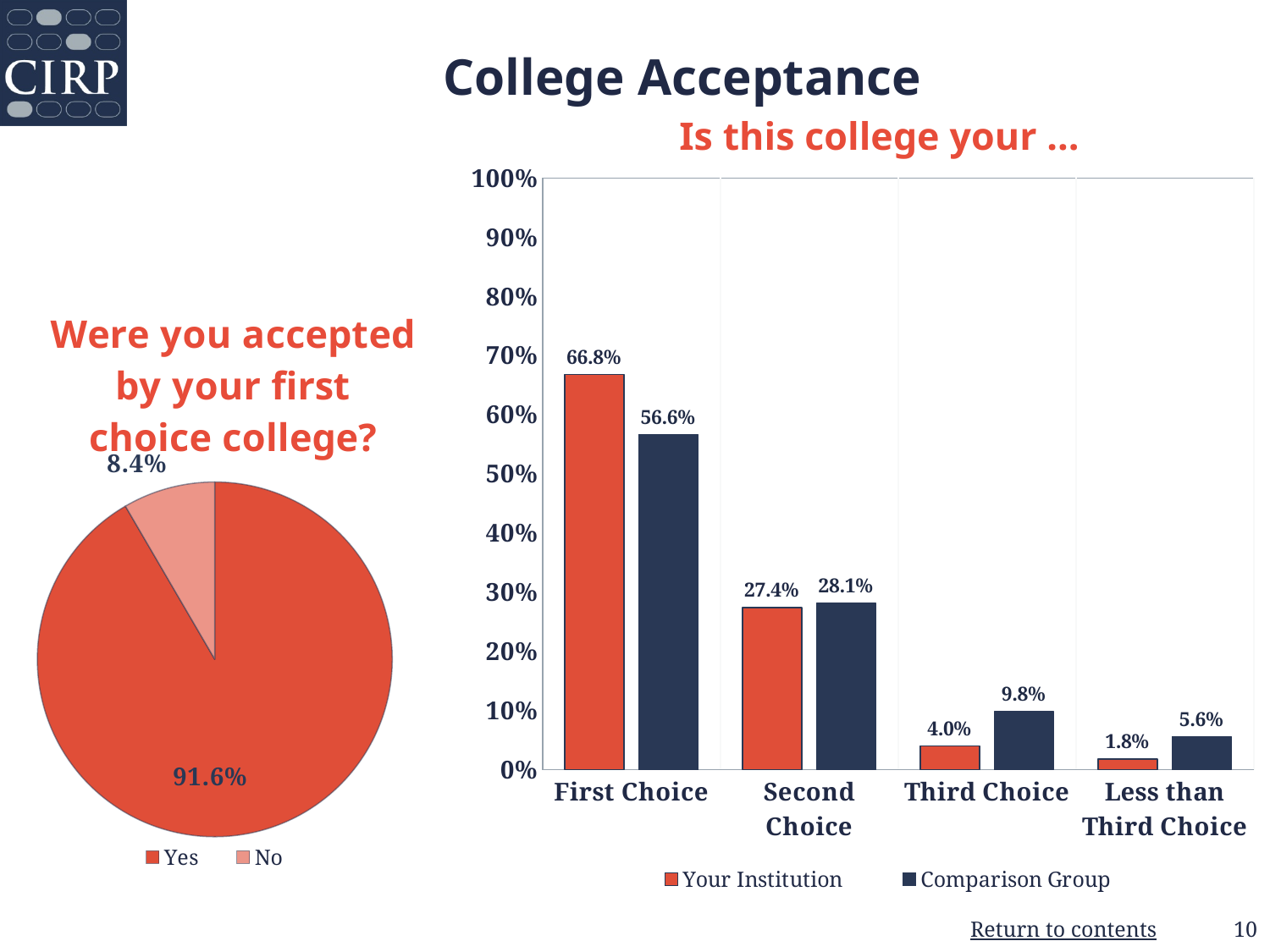
How many categories are shown on the x axis of the 'Is this college your ...' bar chart? 4 In the 'Were you accepted by your first choice college?' pie chart, what share of the pie is 'No'? 8.4% In the 'Is this college your ...' bar chart, what is the value for Your Institution for Less than Third Choice? 1.8% In the 'Is this college your ...' bar chart, what is the difference between Your Institution and Comparison Group for First Choice? 10.2% In the 'Is this college your ...' bar chart, which category has the lowest value for Your Institution? Less than Third Choice In the 'Is this college your ...' bar chart, which is larger for Second Choice: Your Institution or Comparison Group? Comparison Group In the 'Were you accepted by your first choice college?' pie chart, what is the value for 'Yes'? 91.6% What kind of chart is the 'Were you accepted by your first choice college?' chart? Pie chart In the 'Is this college your ...' bar chart, what is the value for Comparison Group for Third Choice? 9.8% In the 'Is this college your ...' bar chart, what is the value for Your Institution for First Choice? 66.8% In the 'Is this college your ...' bar chart, which category has the highest value for Comparison Group? First Choice How many series does the legend of the 'Is this college your ...' bar chart list? 2